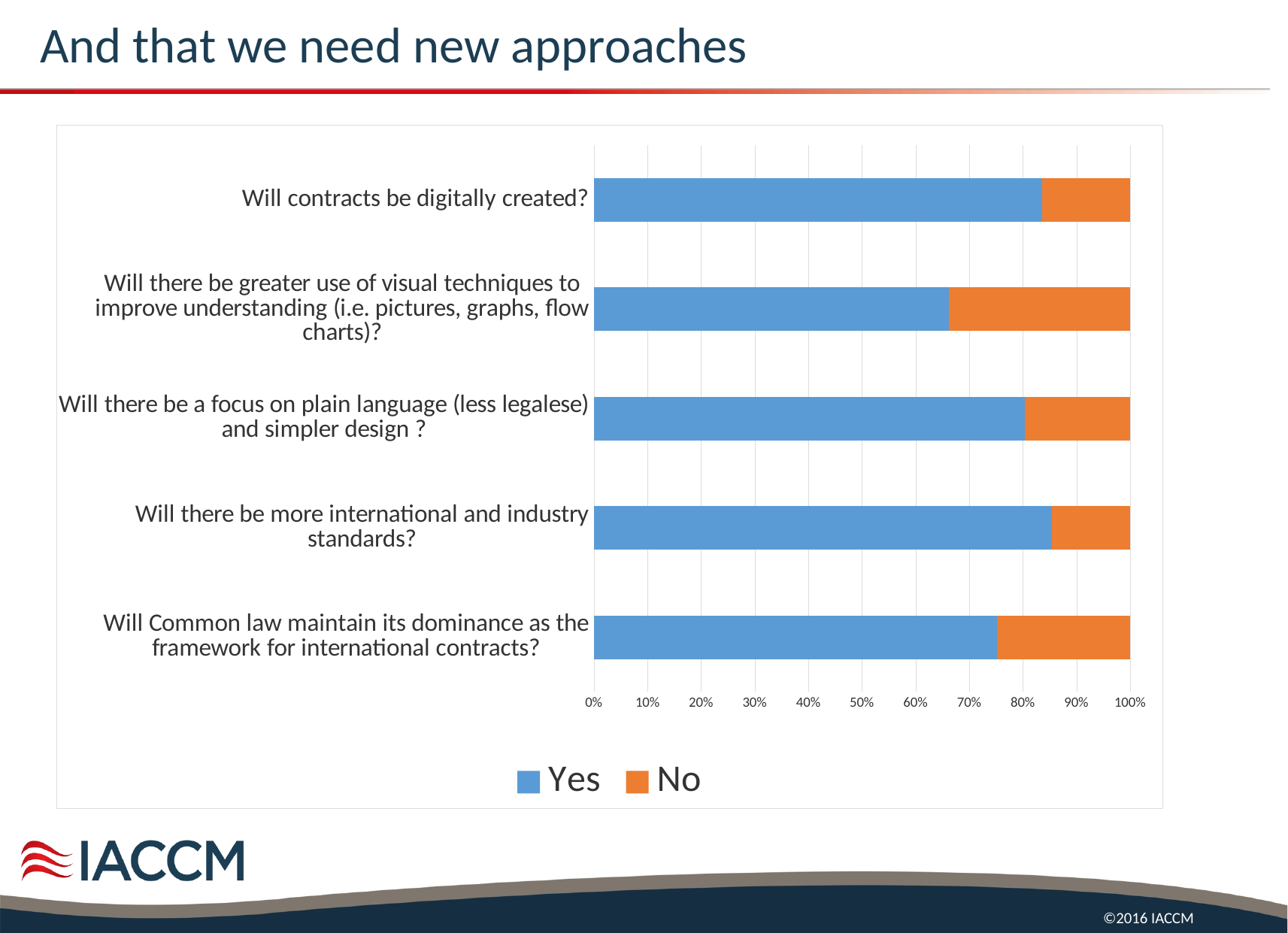
Which question has the highest share of No responses? Will there be greater use of visual techniques to improve understanding (i.e. pictures, graphs, flow charts)? How many questions (categories) are plotted in the chart? 5 Is the Yes share for "Will there be more international and industry standards?" greater or less than 80%? greater Which has a larger Yes share: "Will Common law maintain its dominance" or "Will there be greater use of visual techniques"? Will Common law maintain its dominance as the framework for international contracts? What are the two series named in the legend? Yes and No Which question has the lowest share of Yes responses? Will there be greater use of visual techniques to improve understanding (i.e. pictures, graphs, flow charts)? Is the Yes share for "Will there be a focus on plain language (less legalese) and simpler design?" greater or less than 70%? greater Is the Yes share for "Will there be greater use of visual techniques to improve understanding" greater or less than 70%? less What kind of chart is shown on the slide? Stacked bar chart What is the total of each stacked bar (Yes plus No) in the chart? 100% How many series does the legend list? 2